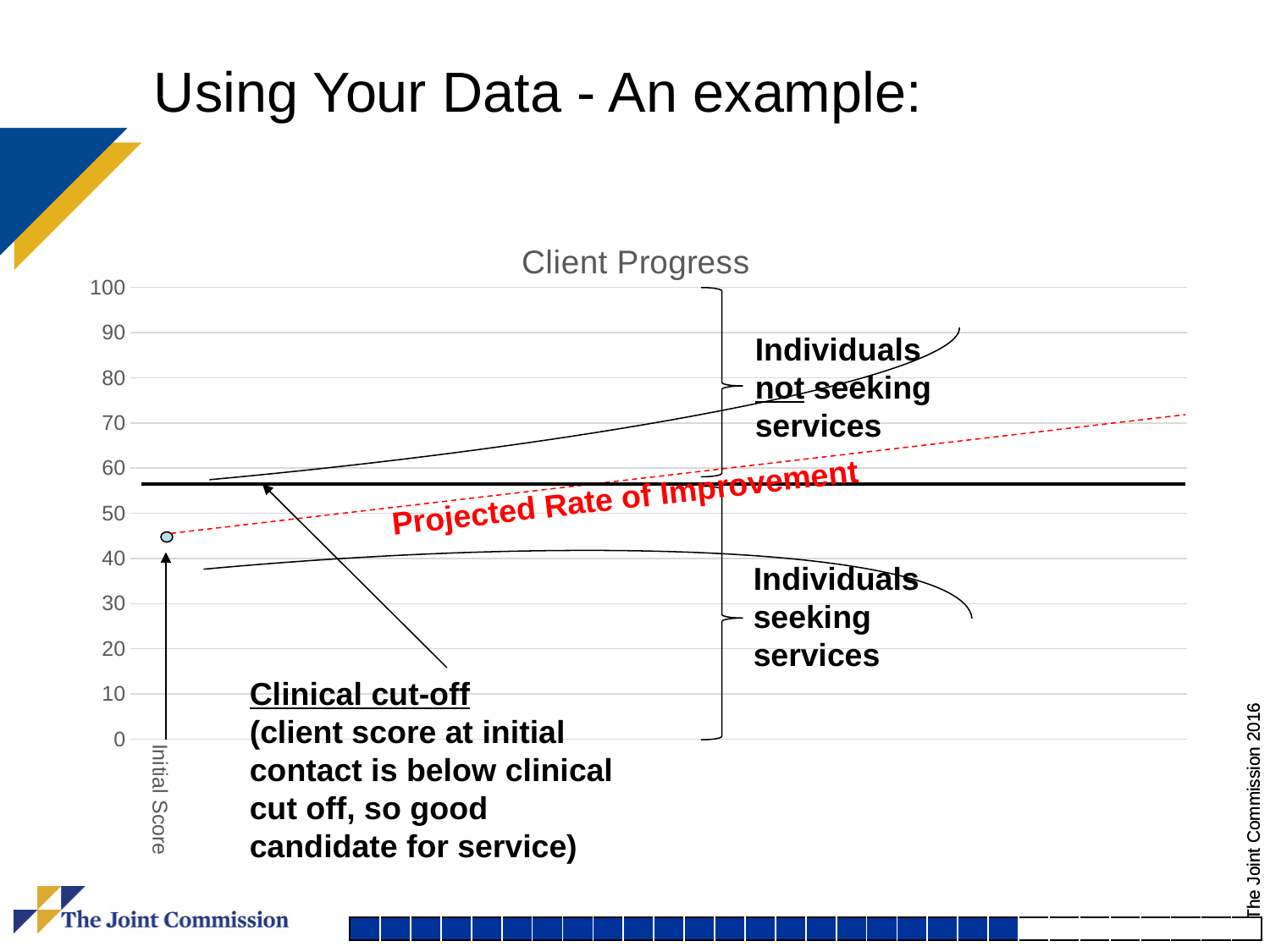
Is the horizontal clinical cut-off line on the Client Progress chart above or below 50 on the y axis? above How many data points are plotted on the Client Progress chart? 1 Is the plotted value for Initial Score greater or less than 40? greater What is the highest value shown on the y axis of the Client Progress chart? 100 Is the Initial Score point plotted above or below the clinical cut-off line? below What is the label of the only category on the x axis of the Client Progress chart? Initial Score Does the red dashed Projected Rate of Improvement line rise or fall from left to right? rise What is the title of the chart on the slide? Client Progress Is the horizontal clinical cut-off line on the Client Progress chart above or below 60 on the y axis? below